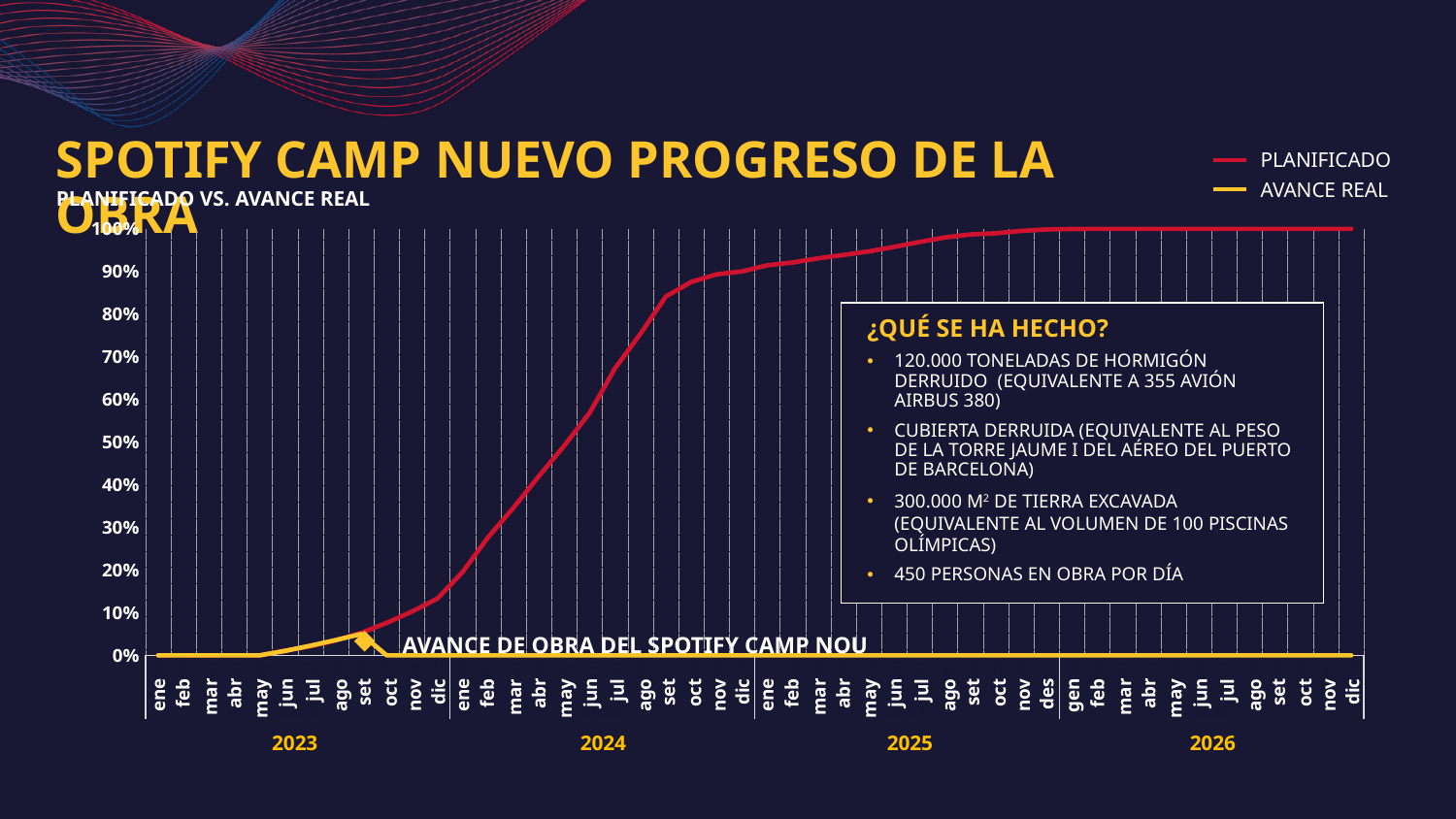
What are the two series named in the legend? PLANIFICADO and AVANCE REAL How many series does the chart legend list? 2 Is the PLANIFICADO value for jun 2024 greater or less than 40%? greater How many years are labelled along the x axis? 4 What kind of chart is shown on the slide? line chart What is the highest value shown on the y axis? 100% Which colour is used for the PLANIFICADO series? red Is the PLANIFICADO value for oct 2024 greater or less than 80%? greater Is the AVANCE REAL value for set 2023 greater or less than 10%? less Does the PLANIFICADO line rise or fall from 2023 to 2026? rise